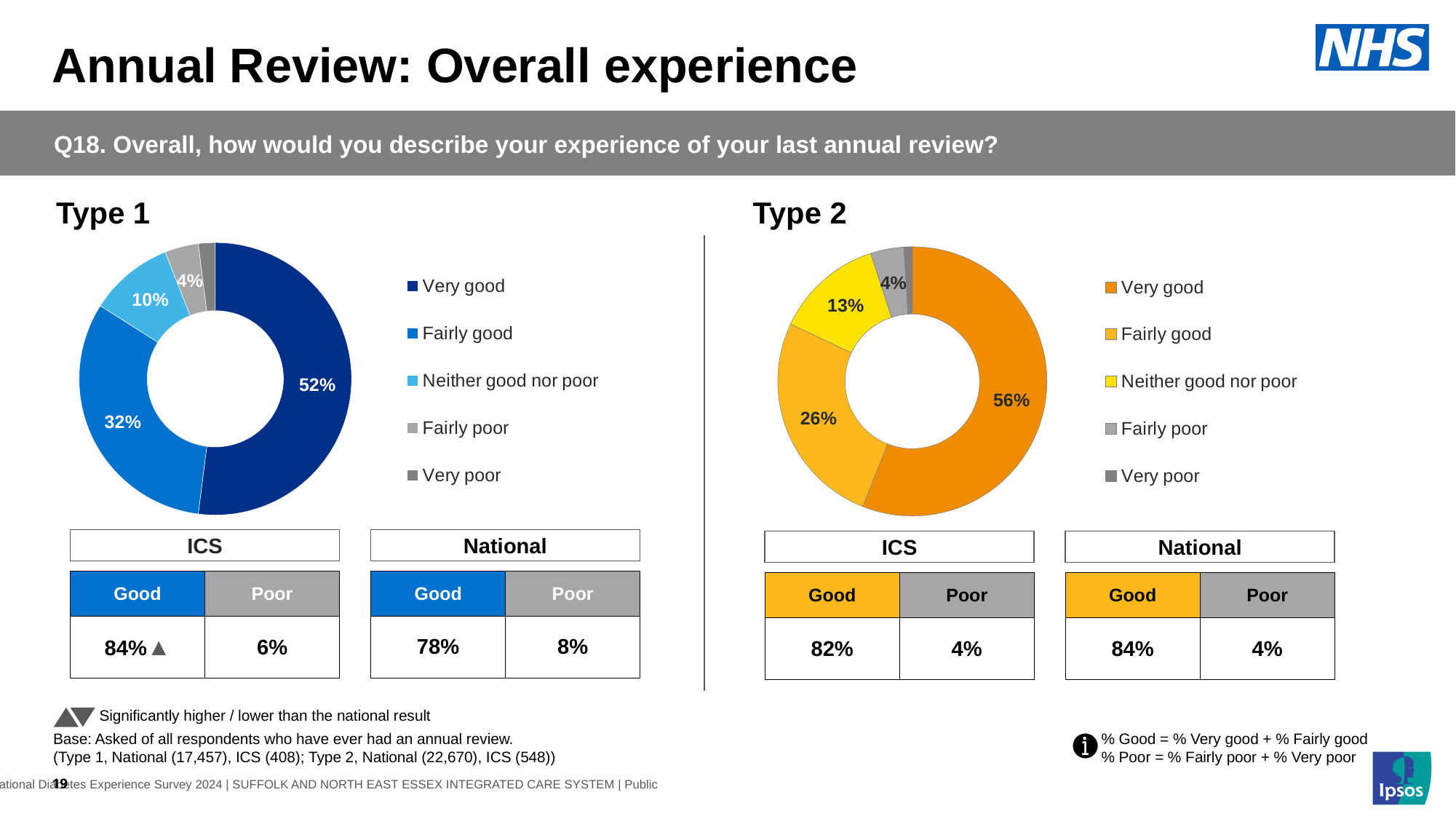
What kind of chart is used for the Type 1 data? Pie (donut) chart In the Type 1 chart, what percentage of respondents said 'Neither good nor poor'? 10% In the Type 1 chart, which labelled category has the smallest share? Fairly poor How many entries does the legend of the Type 2 chart list? 5 In the Type 1 chart, what is the combined share of 'Very good' and 'Fairly good'? 84% Which is larger: the 'Fairly good' share in the Type 1 chart or the 'Fairly good' share in the Type 2 chart? Type 1 What colour represents 'Very good' in the Type 2 chart? Orange In the Type 2 chart, what percentage of respondents said their experience was 'Fairly good'? 26% In the Type 2 chart, which category has the largest share? Very good In the Type 1 chart, what percentage of respondents said their experience was 'Very good'? 52% In the Type 2 chart, what percentage of respondents said 'Neither good nor poor'? 13% What is the difference between the 'Very good' share in the Type 2 chart and the 'Very good' share in the Type 1 chart? 4%